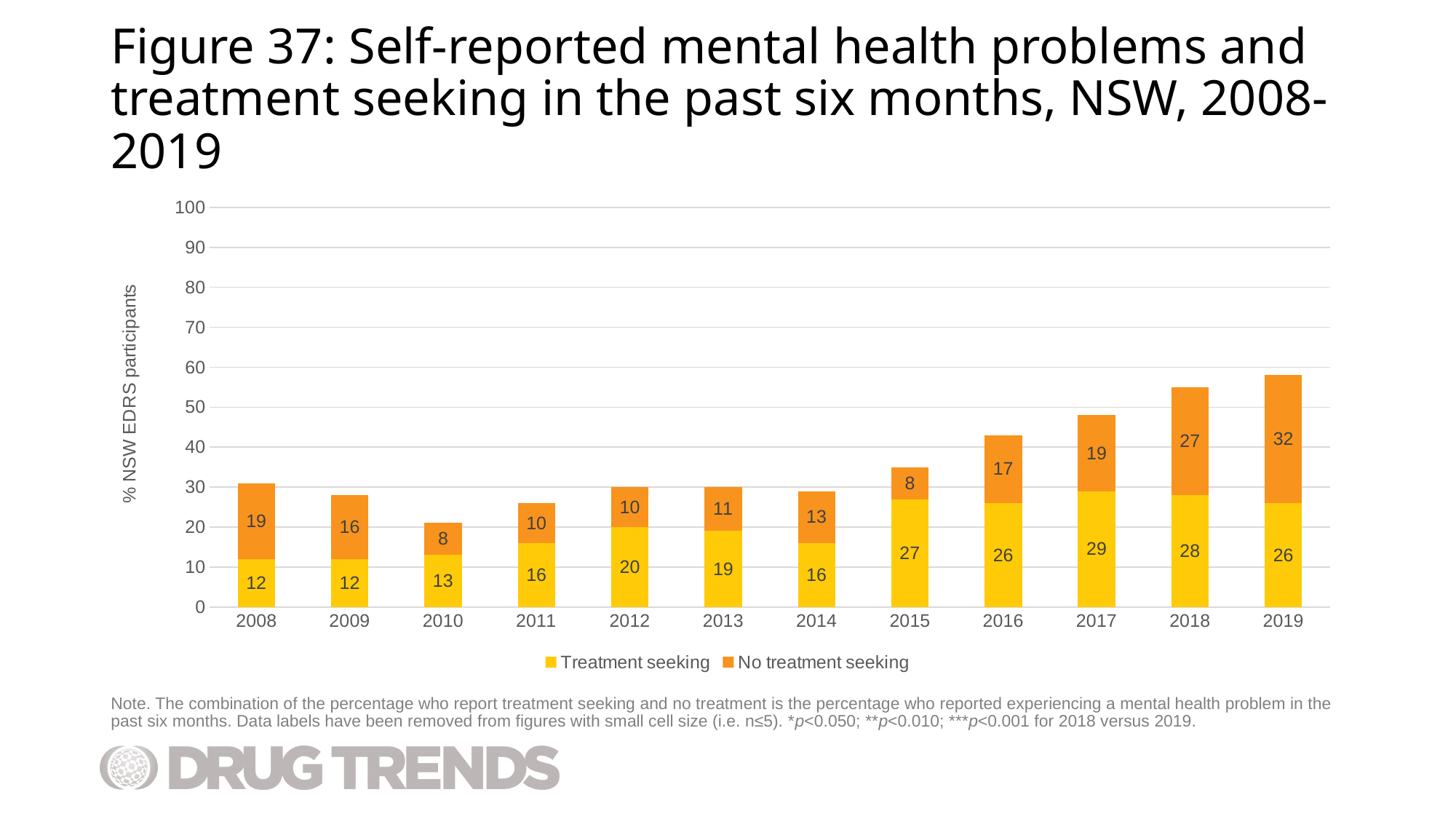
What is the total of the stacked bar for 2008? 31 How many years are shown on the x axis? 12 How many series does the legend list? 2 What is the difference between the No treatment seeking values for 2019 and 2018? 5 In which year is the No treatment seeking value highest? 2019 What is the value for No treatment seeking in 2019? 32 Which is larger: Treatment seeking in 2015 or Treatment seeking in 2014? Treatment seeking in 2015 What is the total of the stacked bar for 2019? 58 What is the value for Treatment seeking in 2012? 20 In which year is the No treatment seeking value lowest? 2010 and 2015 What kind of chart is shown? Stacked bar chart What is the value for Treatment seeking in 2017? 29